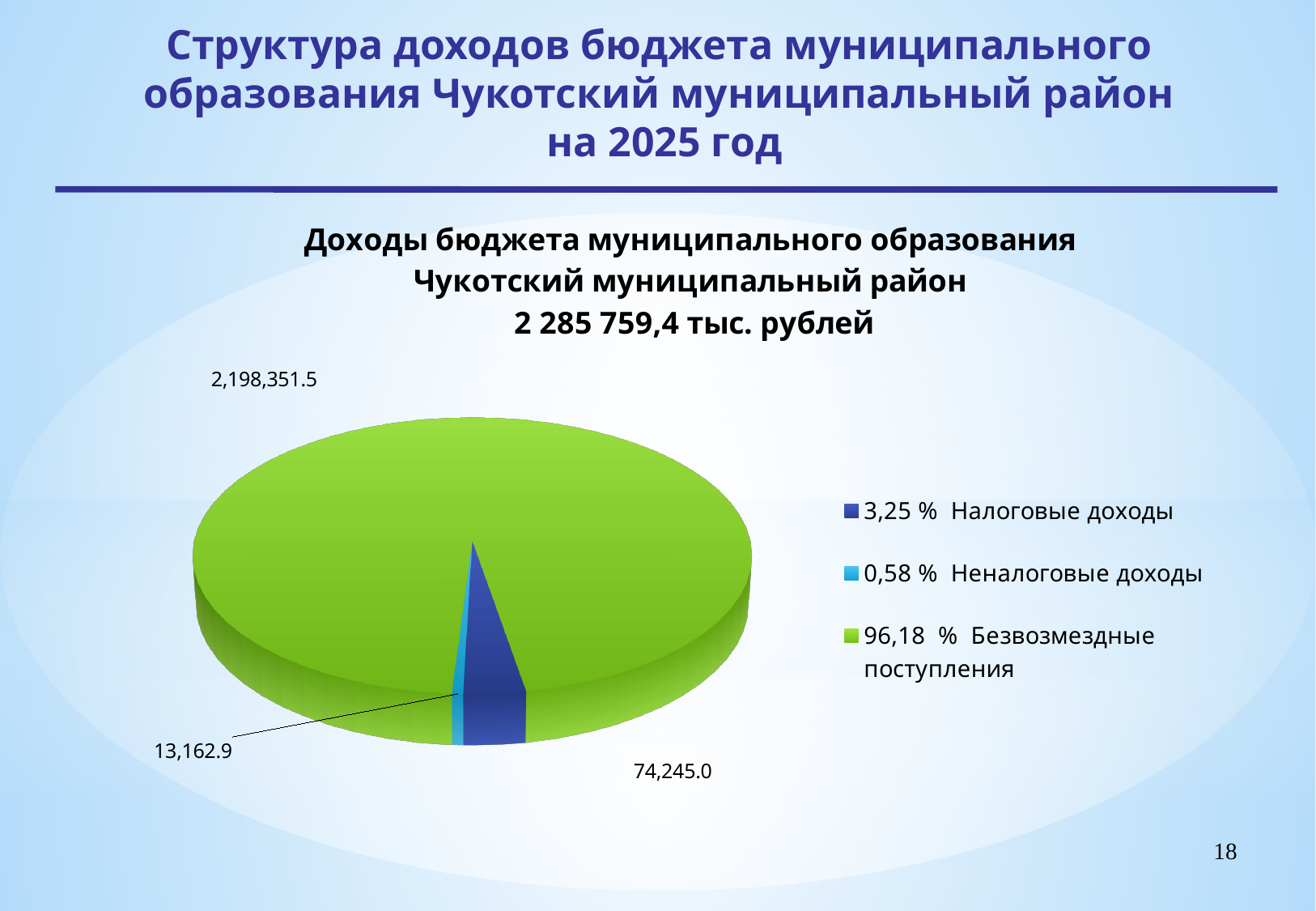
What share of the pie does Неналоговые доходы represent? 0,58 % What is the value for Безвозмездные поступления? 2,198,351.5 Which category has the largest slice of the pie? Безвозмездные поступления What share of the pie does Налоговые доходы represent? 3,25 % What is the difference between the values for Налоговые доходы and Неналоговые доходы? 61,082.1 What share of the pie does Безвозмездные поступления represent? 96,18 % What is the value for Неналоговые доходы? 13,162.9 Which category has the smallest slice of the pie? Неналоговые доходы Which is larger, Налоговые доходы or Неналоговые доходы? Налоговые доходы What kind of chart is shown on the slide? Pie chart What is the value for Налоговые доходы? 74,245.0 How many categories does the pie chart show? 3